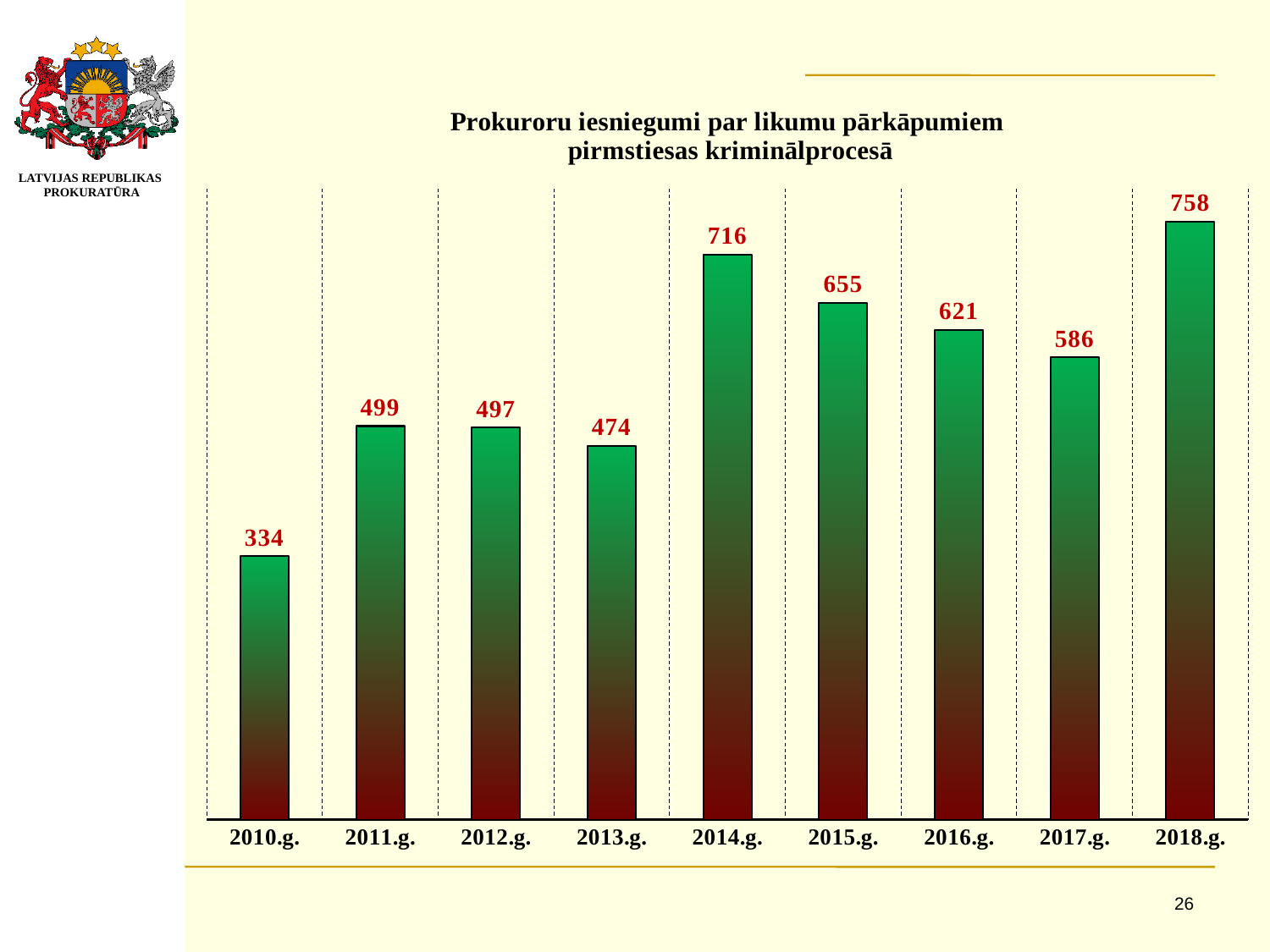
What is the value for 2017.g.? 586 What is the difference between the values for 2018.g. and 2010.g.? 424 Which year has the lowest value? 2010.g. What kind of chart is shown on the slide? bar chart What is the value for 2010.g.? 334 Do the values rise or fall from 2014.g. to 2017.g.? fall Which is larger, the value for 2016.g. or the value for 2017.g.? 2016.g. How many years are shown on the x axis? 9 What is the title of the chart? Prokuroru iesniegumi par likumu pārkāpumiem pirmstiesas kriminālprocesā Which year has the highest value? 2018.g. What is the value for 2014.g.? 716 What is the difference between the values for 2014.g. and 2015.g.? 61